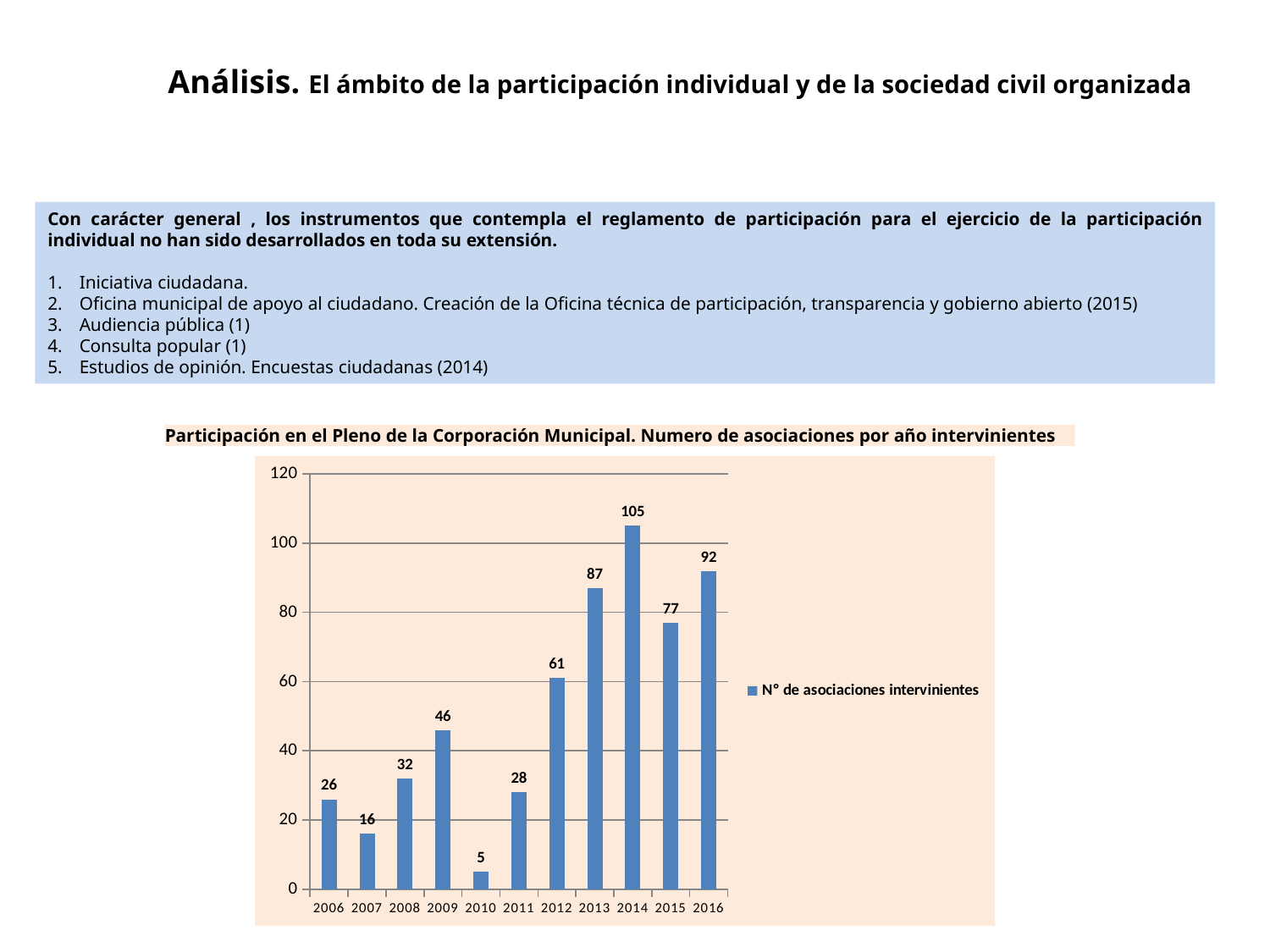
What kind of chart is shown on the slide? Bar chart How many series does the legend list? 1 Which year has the lowest number of associations intervening? 2010 What is the difference between the values for 2014 and 2015? 28 What is the number of associations intervening in 2014? 105 What is the legend entry of the chart? Nº de asociaciones intervinientes How many years are shown on the x axis of the chart? 11 Which year has a larger value, 2013 or 2016? 2016 Is the value for 2012 greater or less than 60? greater What is the value shown for 2016? 92 Which year has the highest number of associations intervening? 2014 What is the value shown for 2010? 5